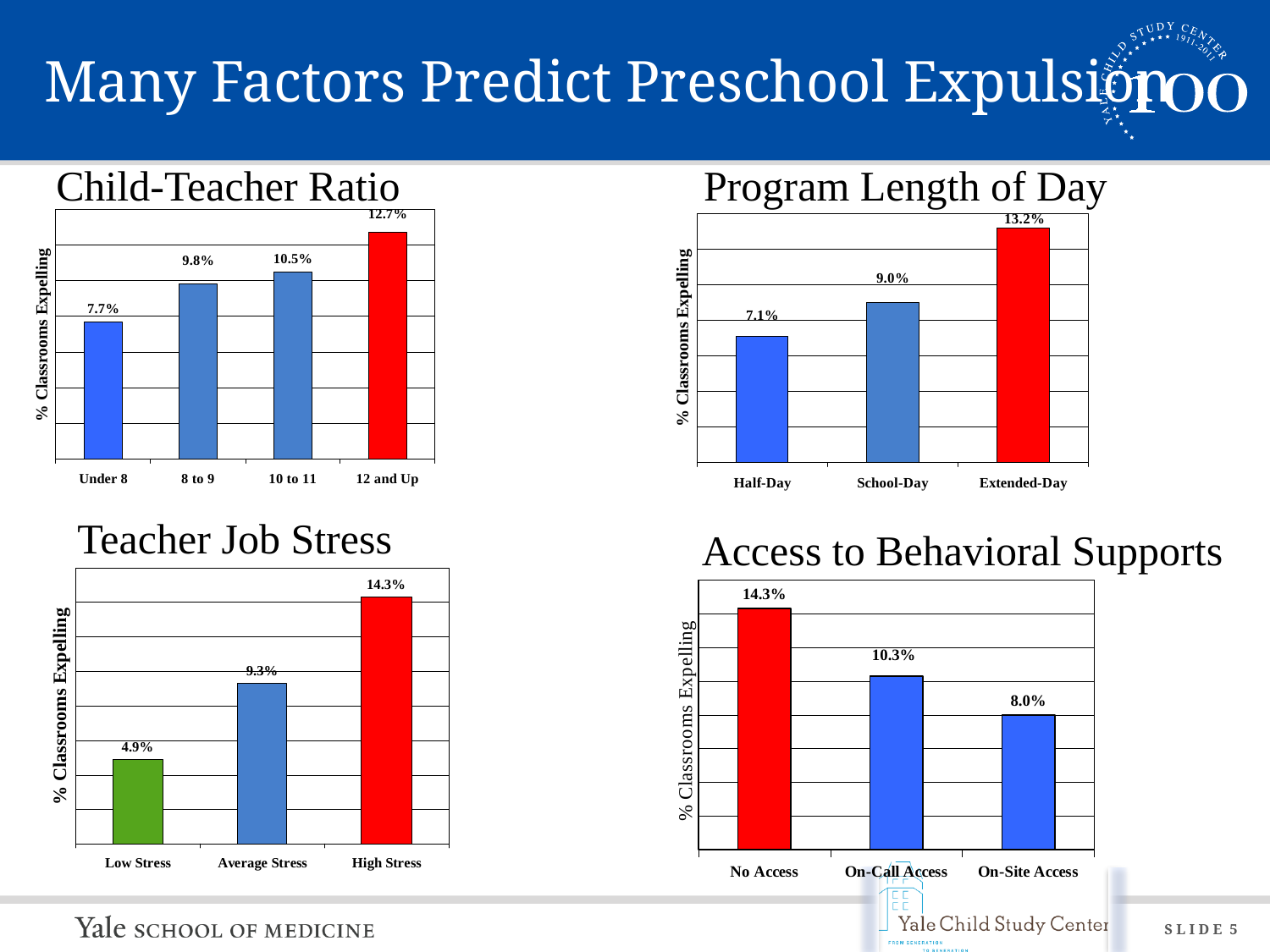
In the Child-Teacher Ratio chart, what is the difference between the 10 to 11 and 8 to 9 values? 0.7% In the Access to Behavioral Supports chart, which is larger, No Access or On-Call Access? No Access In the Child-Teacher Ratio chart, which category has the lowest value? Under 8 In the Teacher Job Stress chart, what is the difference between High Stress and Low Stress? 9.4% In the Teacher Job Stress chart, do the values rise or fall from Low Stress to High Stress? rise In the Program Length of Day chart, how many categories are shown? 3 In the Teacher Job Stress chart, what is the value for Low Stress? 4.9% In the Program Length of Day chart, what is the value for School-Day? 9.0% What type of chart is the Child-Teacher Ratio chart? bar chart In the Program Length of Day chart, which category has the highest value? Extended-Day In the Access to Behavioral Supports chart, what is the value for On-Site Access? 8.0% In the Child-Teacher Ratio chart, what is the value for the 12 and Up category? 12.7%